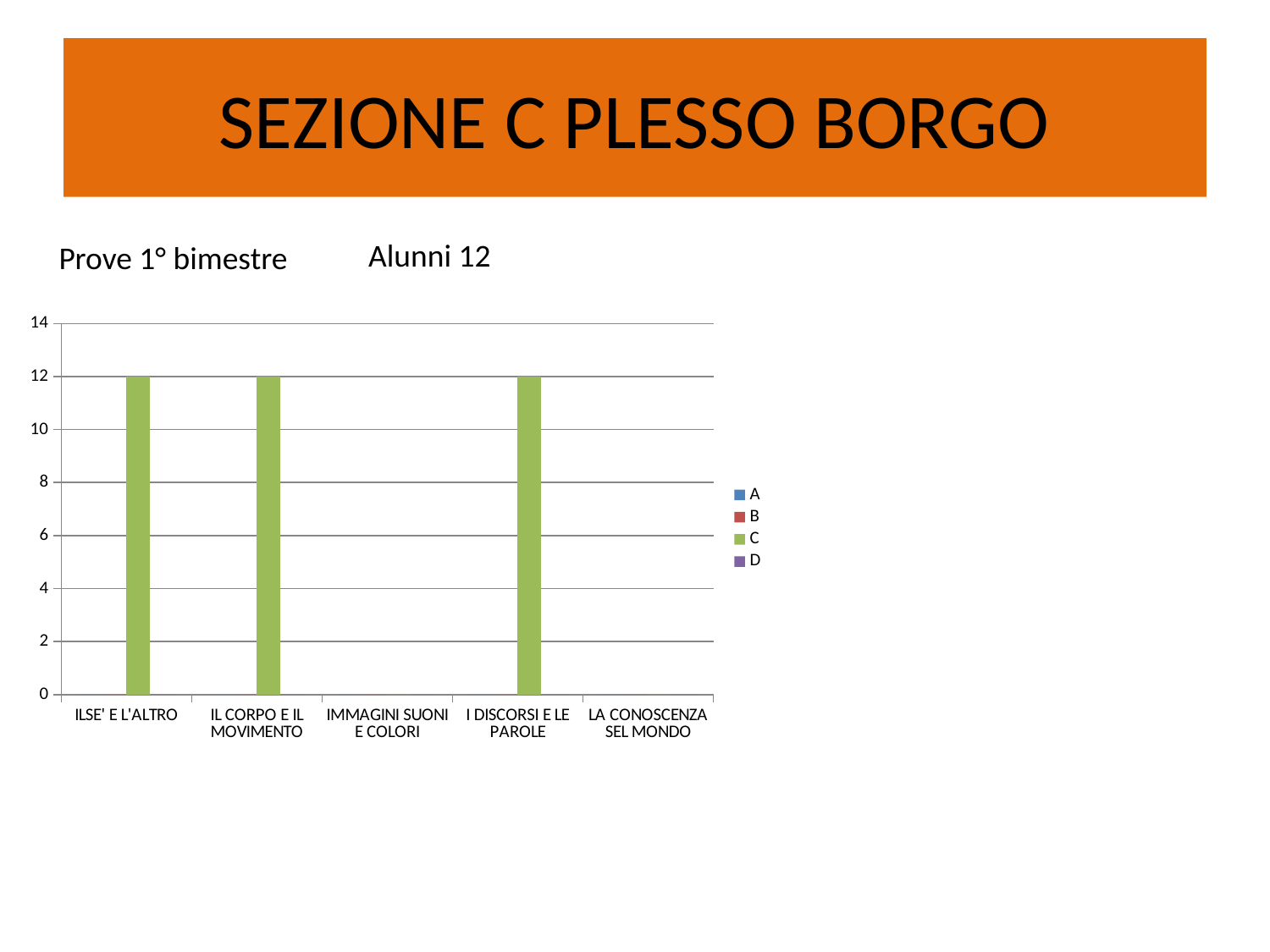
What is the value of series C for I DISCORSI E LE PAROLE? 12 What is the highest value shown on the vertical axis of the chart? 14 What is the value of series C for IL CORPO E IL MOVIMENTO? 12 Which series is the only one with visible bars in the chart? C How many series does the chart's legend list? 4 Which categories have no visible bar in the chart? IMMAGINI SUONI E COLORI and LA CONOSCENZA SEL MONDO Which series is shown in green in the legend? C What is the value of series C for ILSE' E L'ALTRO? 12 Is the value of series C for I DISCORSI E LE PAROLE greater or less than 10? greater How many categories are shown on the x axis of the chart? 5 What kind of chart is shown on the slide? bar chart Is the value of series C for ILSE' E L'ALTRO greater or less than 14? less